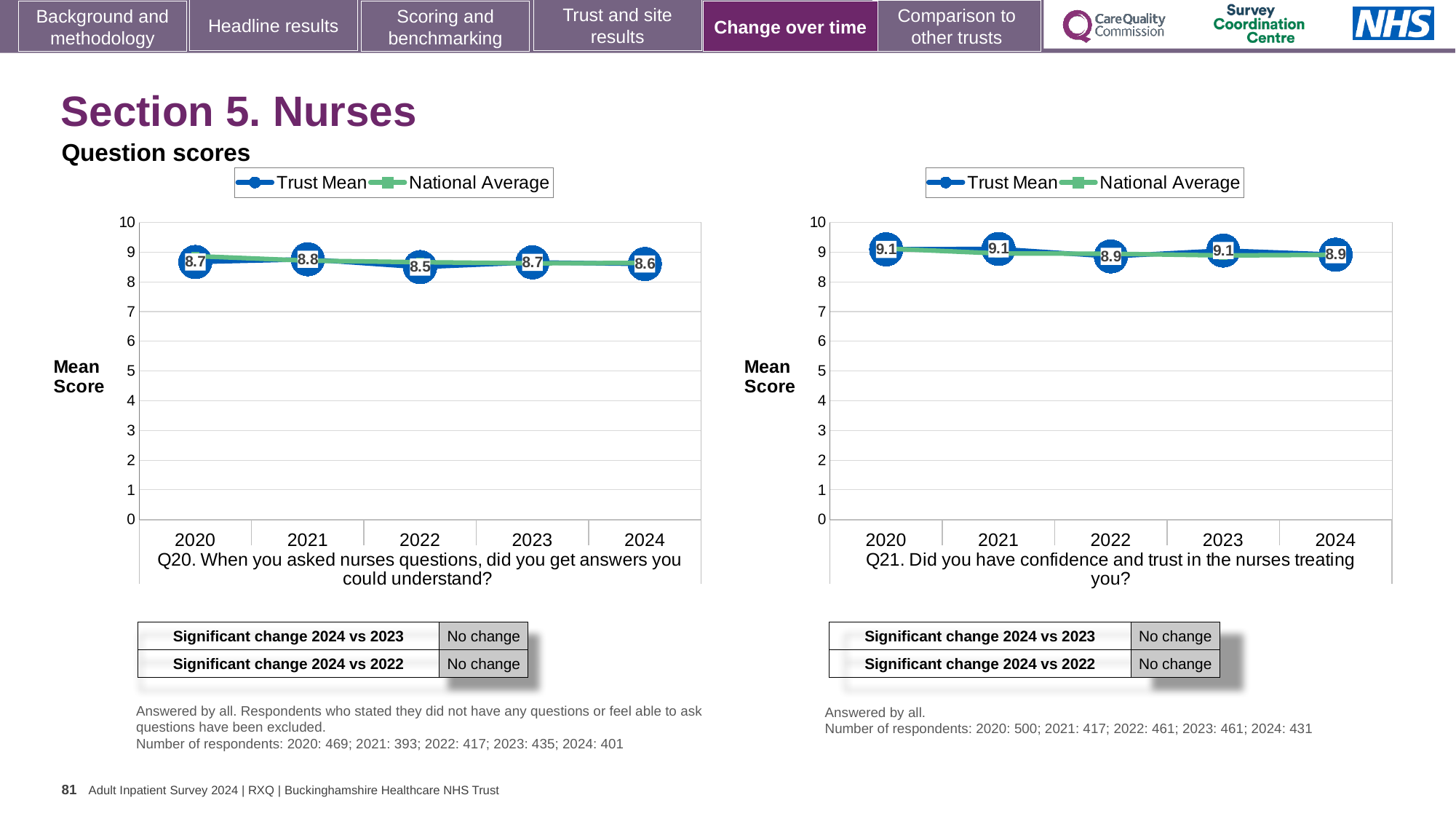
On the Q20 chart, what is the difference between the Trust Mean scores for 2021 and 2022? 0.3 How many series does the legend of the Q20 chart list? 2 On the Q20 chart, which year has the highest Trust Mean score? 2021 On the Q21 chart, what is the Trust Mean score for 2024? 8.9 On the Q20 chart, is the National Average value for 2020 greater or less than 8? greater How many years are plotted on the Q21 chart? 5 What kind of chart is the Q21 chart? line chart On the Q20 chart, does the Trust Mean score rise or fall from 2021 to 2022? fall On the Q20 chart, which year has the lowest Trust Mean score? 2022 On the Q21 chart, what is the difference between the Trust Mean scores for 2023 and 2024? 0.2 On the Q21 chart, is the Trust Mean score for 2020 larger or smaller than the score for 2022? larger On the Q20 chart, what is the Trust Mean score for 2022? 8.5